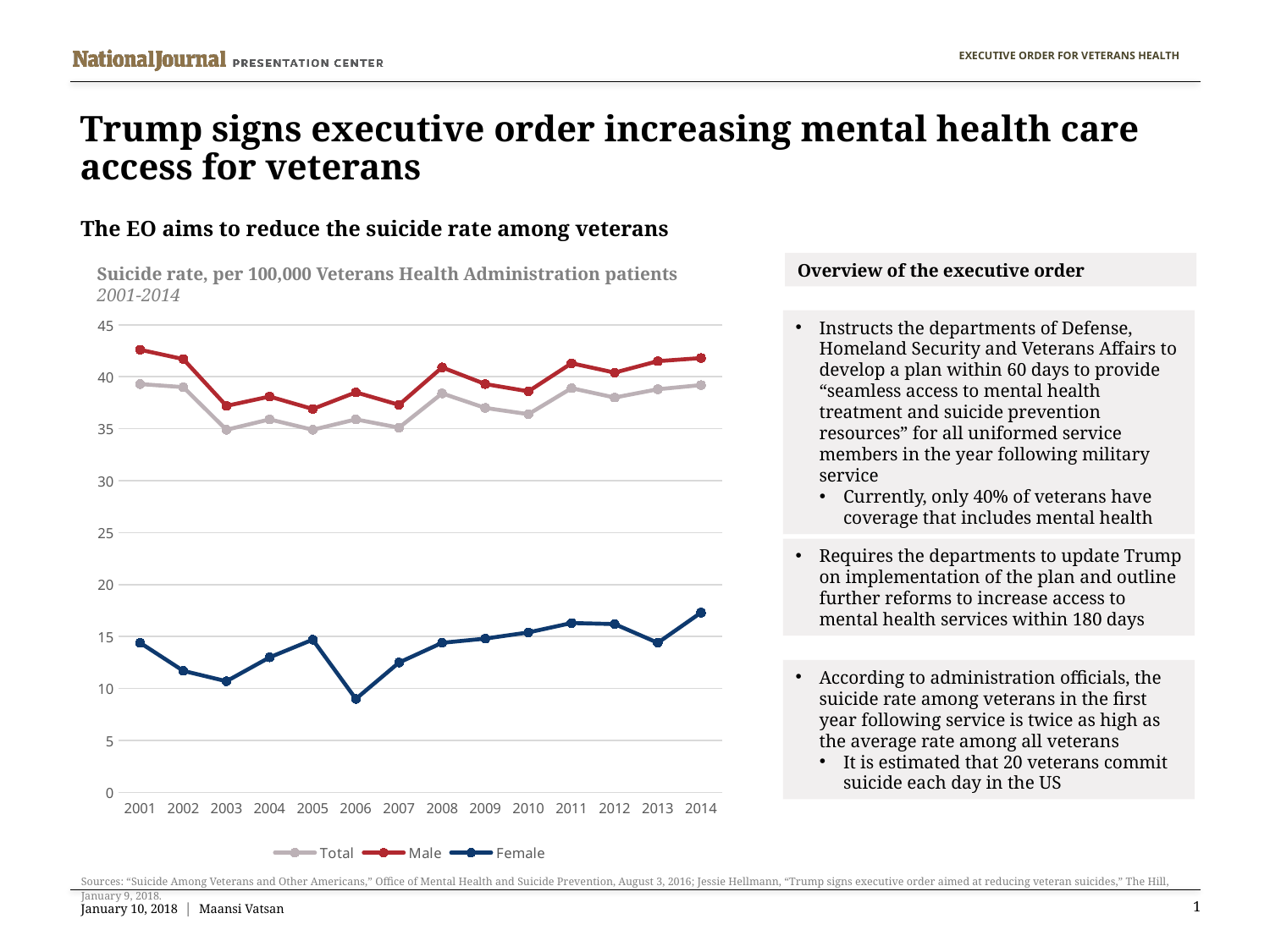
What colour is the Male line in the chart? red Is the Female suicide rate in 2014 greater or less than 15? greater In 2010, which series has the higher suicide rate, Male or Female? Male How many series does the chart legend list? 3 Is the Male suicide rate in 2001 greater or less than 40? greater Does the Female suicide rate rise or fall between 2006 and 2011? rise What kind of chart is shown on the slide? line chart Is the Total suicide rate in 2008 greater or less than 35? greater In which year is the Female suicide rate highest? 2014 In which year is the Female suicide rate lowest? 2006 How many years are plotted along the x axis of the chart? 14